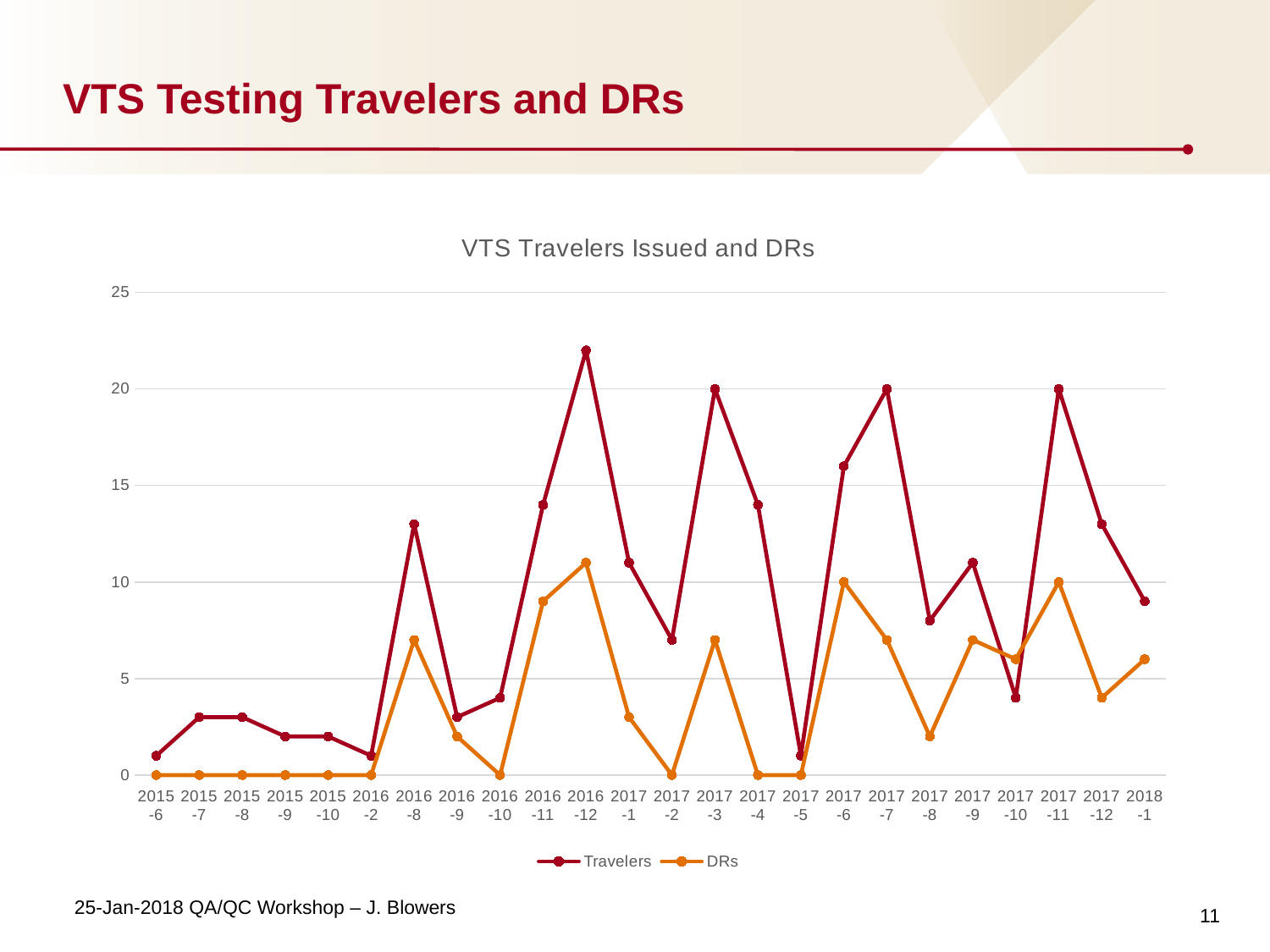
In 2017-3, which series has the larger value, Travelers or DRs? Travelers What is the title of the chart? VTS Travelers Issued and DRs How many series does the legend list? 2 What kind of chart is shown on the slide? line chart How many time periods are plotted along the x axis? 24 What are the two series named in the legend? Travelers and DRs Is the value for Travelers in 2016-12 greater or less than 20? greater What is the value of Travelers in 2017-3? 20 What is the value of DRs in 2017-6? 10 In which period does the Travelers series reach its highest value? 2016-12 What is the value of DRs in 2015-6? 0 Is the value for DRs in 2016-8 greater or less than 5? greater